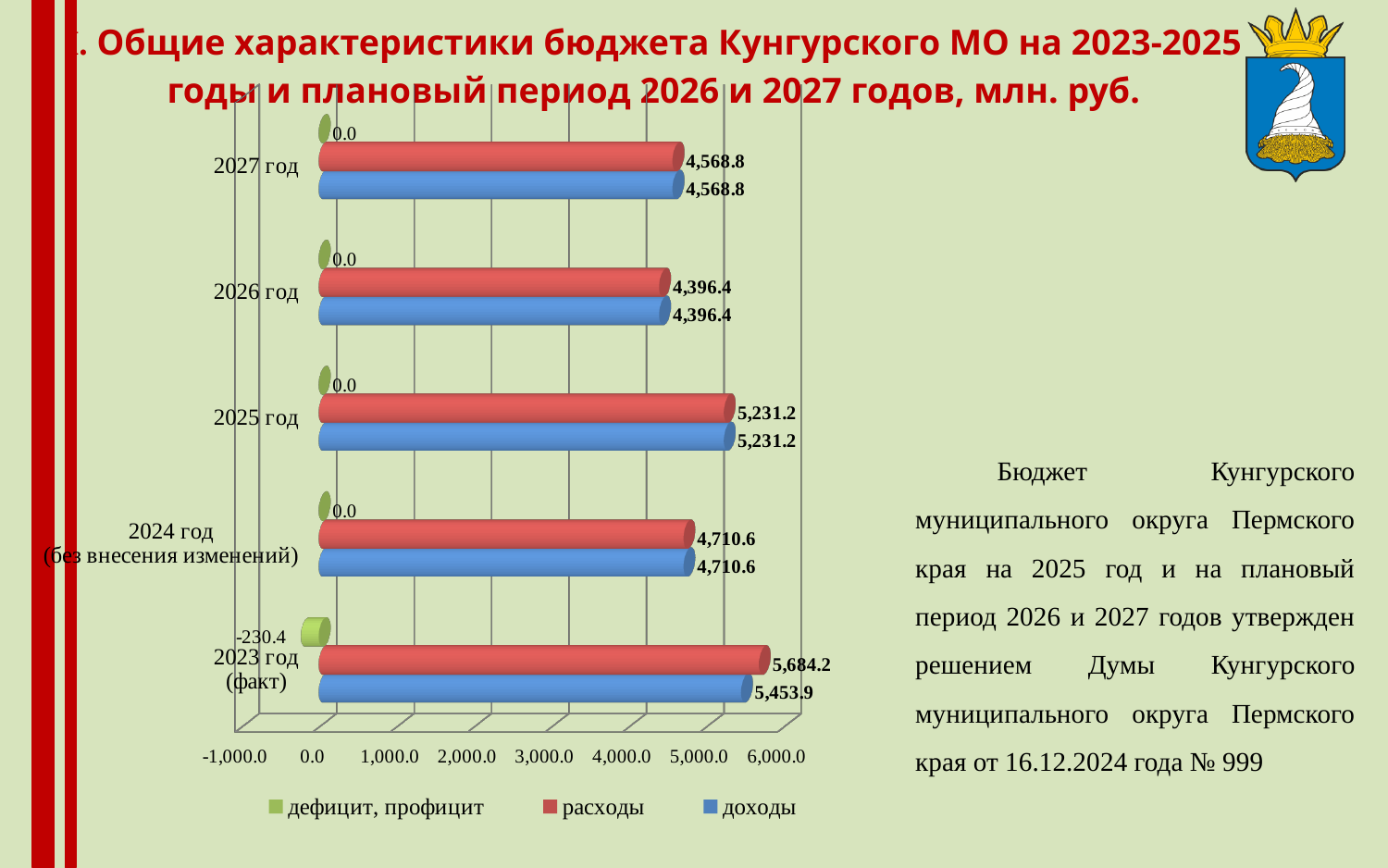
What kind of chart is shown on the slide? Bar chart What is the value of доходы for 2025 год? 5,231.2 Which year has the highest value of расходы? 2023 год (факт) How many year categories are shown on the chart? 5 What is the value of дефицит, профицит for 2023 год (факт)? -230.4 How many series does the legend list? 3 What is the value of расходы for 2026 год? 4,396.4 Which is larger: доходы for 2027 год or доходы for 2024 год (без внесения изменений)? 2024 год (без внесения изменений) What is the value of расходы for 2023 год (факт)? 5,684.2 What is the difference between расходы and доходы for 2023 год (факт)? 230.3 What is the value of доходы for 2023 год (факт)? 5,453.9 Which year has the lowest value of доходы? 2026 год